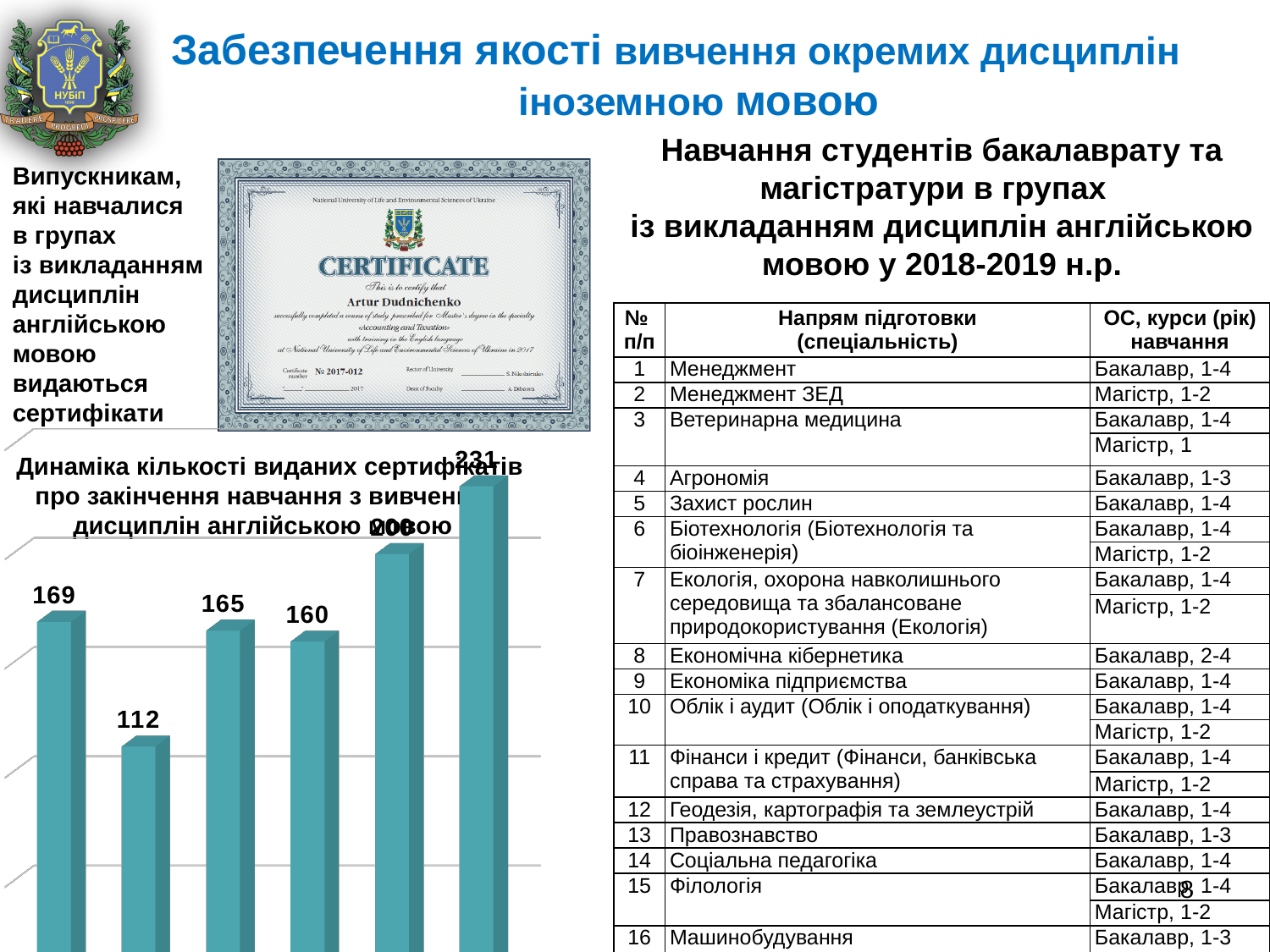
Which bar in the chart has the highest value? the last (rightmost) bar, 231 What is the value shown on the first (leftmost) bar of the chart? 169 What is the difference between the first bar (169) and the second bar (112) in the chart? 57 What is the value shown on the second bar of the chart? 112 What is the value shown on the last (rightmost) bar of the chart? 231 What kind of chart is shown on the slide? bar chart Which is larger in the chart: the first bar or the third bar? the first bar (169) What is the title of the bar chart on the slide? Динаміка кількості виданих сертифікатів про закінчення навчання з вивченням дисциплін англійською мовою What is the value shown on the third bar of the chart? 165 Which bar in the chart has the lowest value? the second bar, 112 What is the value shown on the fourth bar of the chart? 160 How many bars does the chart on the slide contain? 6